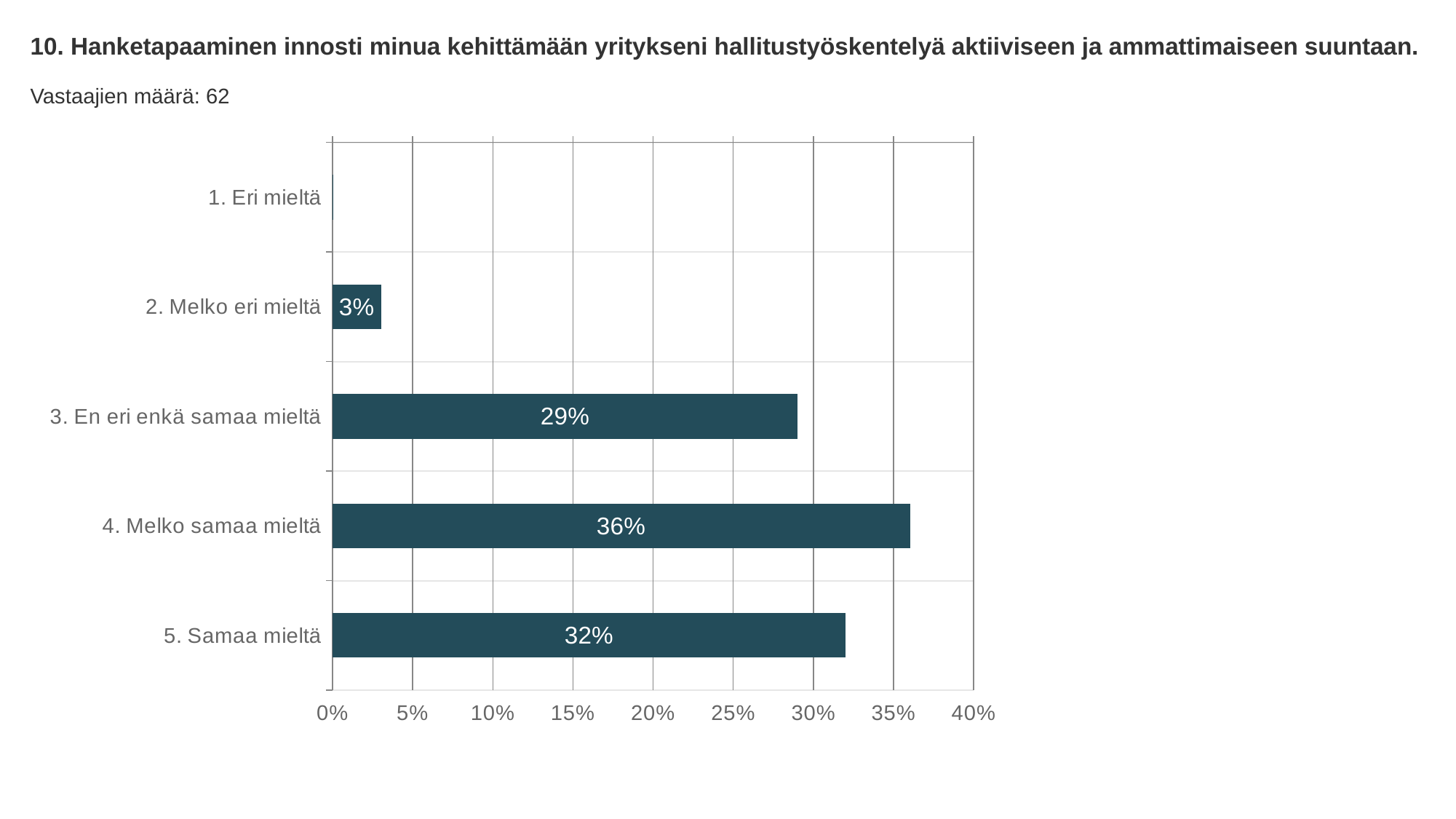
Which response category has the lowest percentage? 1. Eri mieltä What percentage of respondents chose "5. Samaa mieltä"? 32% What is the difference in percentage points between "4. Melko samaa mieltä" and "5. Samaa mieltä"? 4% What kind of chart is shown on the slide? Bar chart How many response categories are shown on the chart? 5 How many respondents (Vastaajien määrä) are reported on the slide? 62 Which has a larger share, "3. En eri enkä samaa mieltä" or "5. Samaa mieltä"? 5. Samaa mieltä What percentage of respondents chose "2. Melko eri mieltä"? 3% What percentage of respondents chose "3. En eri enkä samaa mieltä"? 29% What percentage of respondents chose "4. Melko samaa mieltä"? 36% Is the value for "3. En eri enkä samaa mieltä" greater or less than 30%? less Which response category has the highest percentage? 4. Melko samaa mieltä